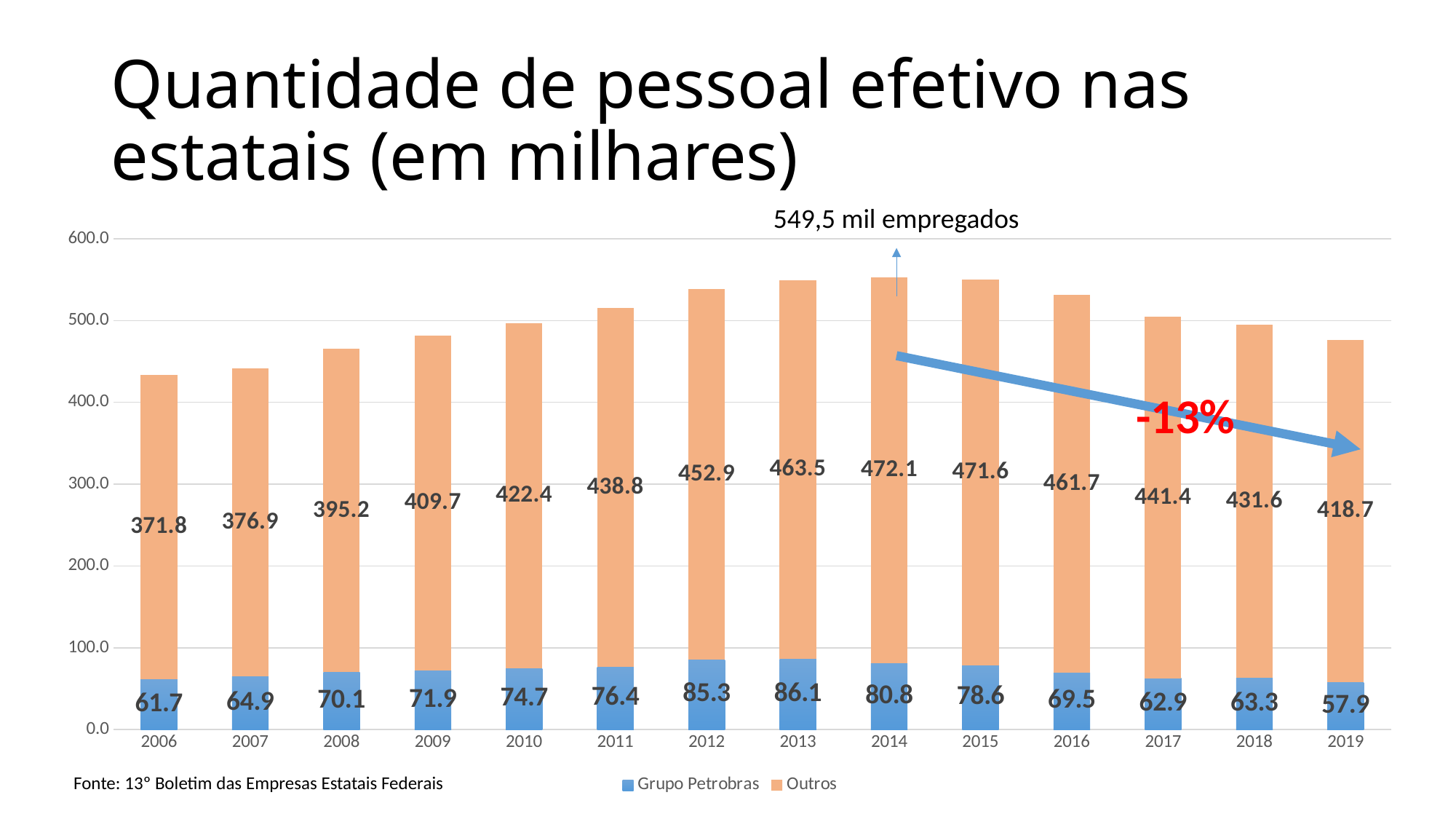
In which year is the Outros value highest? 2014 What is the value for Grupo Petrobras in 2019? 57.9 How many series does the legend list? 2 In which year is the Grupo Petrobras value highest? 2013 In which year is the Grupo Petrobras value lowest? 2019 What kind of chart is shown on the slide? Stacked bar chart What is the total of the stacked bar for 2019? 476.6 Which is larger, the Grupo Petrobras value for 2011 or for 2015? 2015 What is the difference between the Outros values for 2014 and 2019? 53.4 How many years are shown on the x axis? 14 What is the value for Outros in 2014? 472.1 Does the Outros value rise or fall from 2014 to 2019? Fall